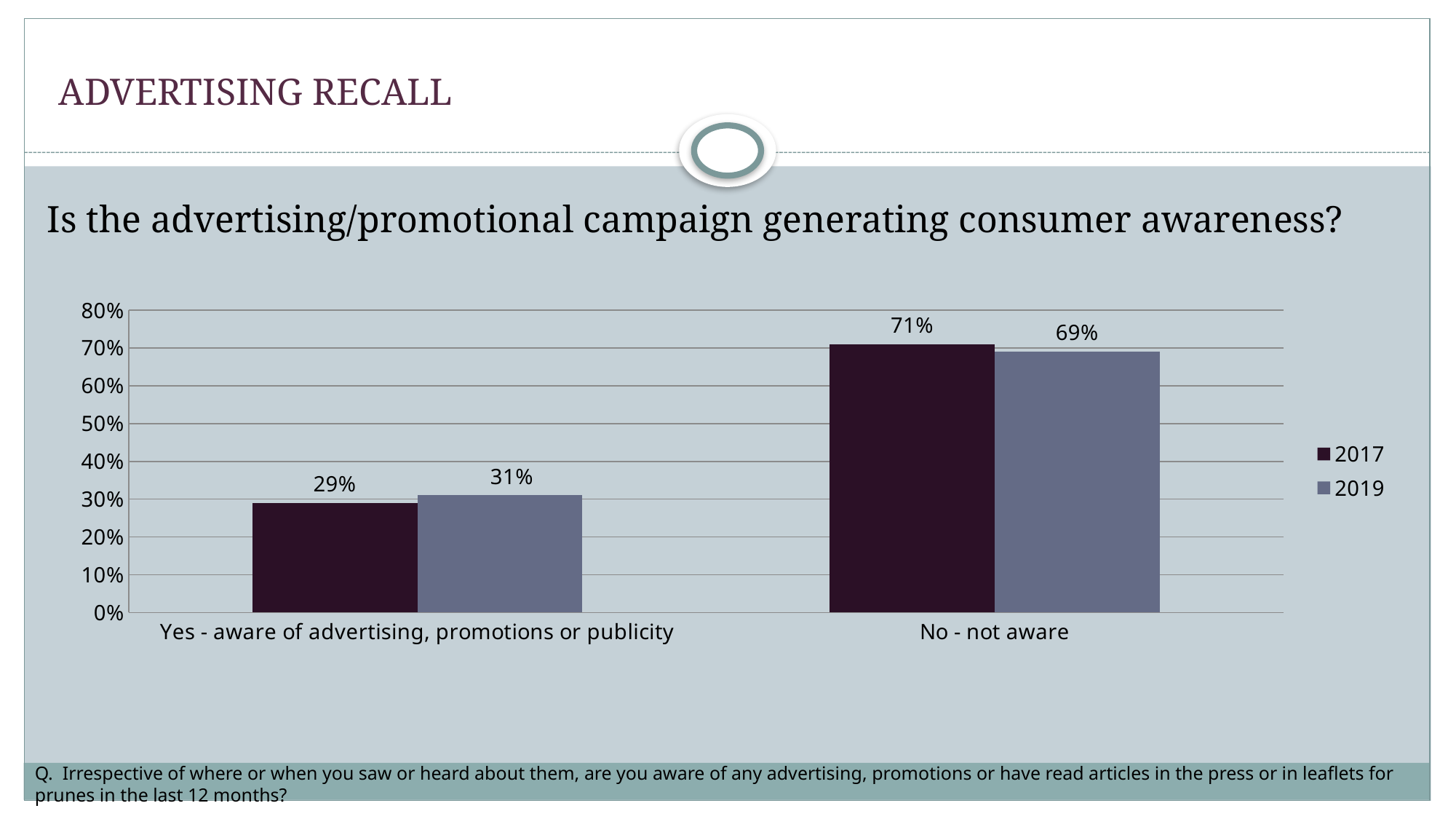
Which years are listed in the legend? 2017 and 2019 What is the 2019 value for "No - not aware"? 69% Which category has the lowest 2019 value? Yes - aware of advertising, promotions or publicity What is the 2017 value for "Yes - aware of advertising, promotions or publicity"? 29% For "Yes - aware of advertising, promotions or publicity", which year has the larger value, 2017 or 2019? 2019 What is the 2019 value for "Yes - aware of advertising, promotions or publicity"? 31% What kind of chart is shown on the slide? Bar chart Which category has the highest 2017 value? No - not aware What is the 2017 value for "No - not aware"? 71% How many series does the legend list? 2 How many categories are shown on the x axis? 2 What is the difference between the 2017 and 2019 values for "No - not aware"? 2%